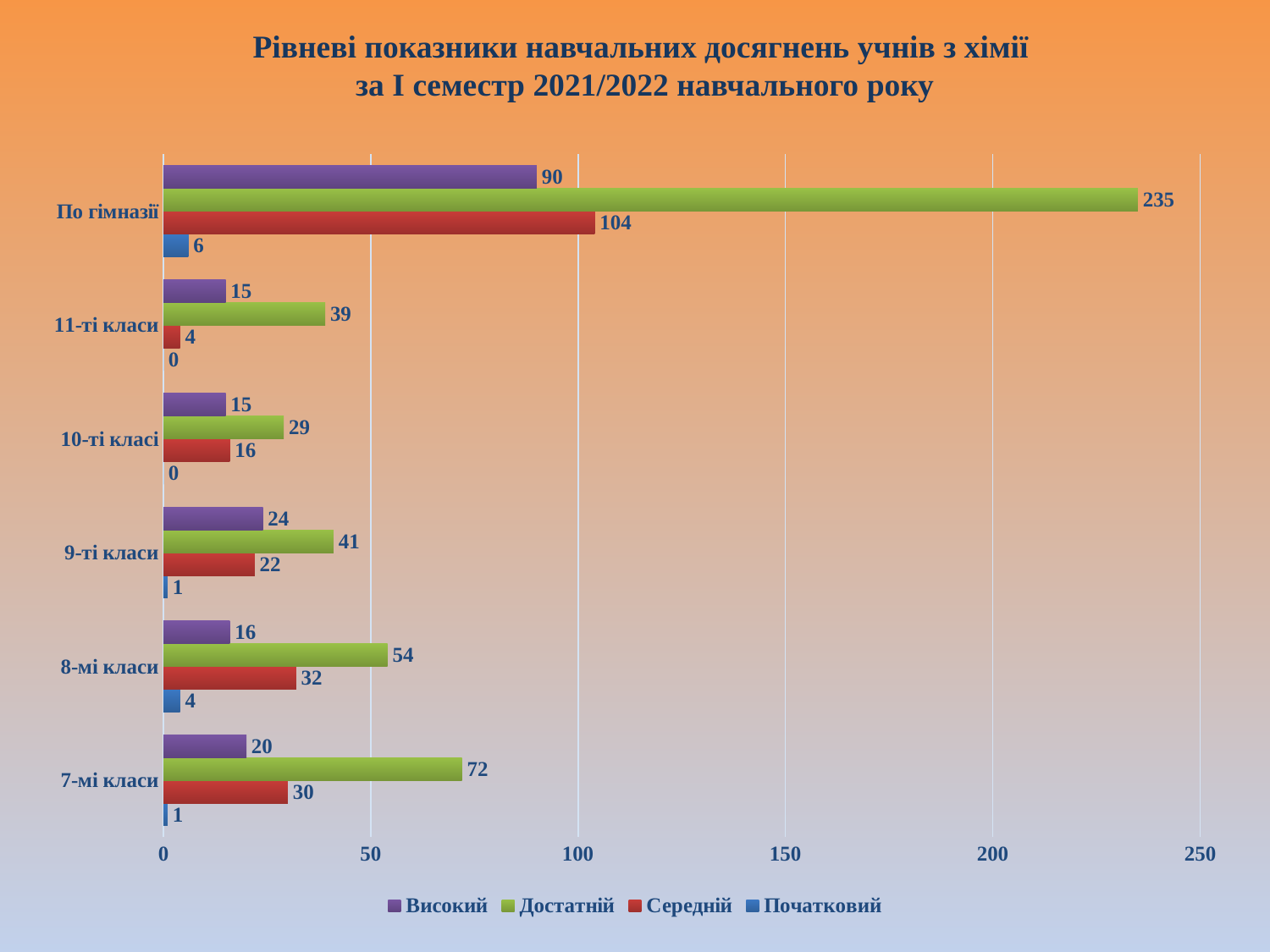
How many categories are shown on the y axis? 6 What is the value of Високий for 9-ті класи? 24 What is the difference between the Достатній values for 7-мі класи and 8-мі класи? 18 How many series does the legend list? 4 What is the value of Середній for 8-мі класи? 32 Which is larger: the Високий value for 7-мі класи or for 8-мі класи? 7-мі класи Which category has the highest Достатній value? По гімназії What is the value of Достатній for По гімназії? 235 What kind of chart is shown on the slide? bar chart Is the Середній value for По гімназії greater or less than 100? greater Among the class groups (excluding По гімназії), which has the lowest Середній value? 11-ті класи What is the value of Початковий for 11-ті класи? 0